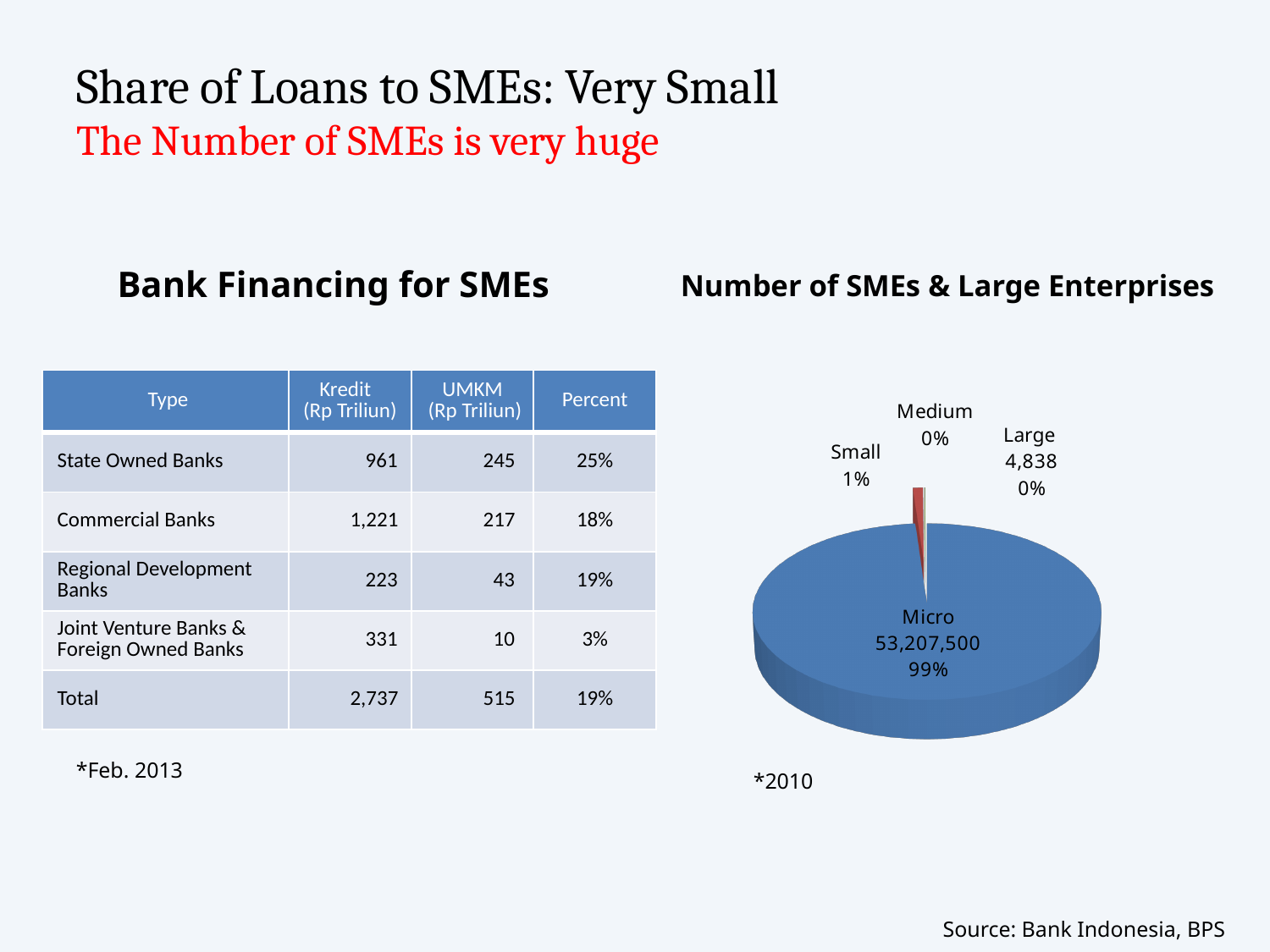
In the "Number of SMEs & Large Enterprises" pie chart, what is the number shown for Large? 4,838 In the "Number of SMEs & Large Enterprises" pie chart, what share of the pie is Micro? 99% What year is noted below the "Number of SMEs & Large Enterprises" pie chart? 2010 In the "Number of SMEs & Large Enterprises" pie chart, what is the number shown for Micro? 53,207,500 In the "Number of SMEs & Large Enterprises" pie chart, what is the difference between the number for Micro and the number for Large? 53,202,662 What kind of chart is shown under the title "Number of SMEs & Large Enterprises"? pie chart In the "Number of SMEs & Large Enterprises" pie chart, which category has the largest slice? Micro How many slices does the "Number of SMEs & Large Enterprises" pie chart have? 4 In the "Number of SMEs & Large Enterprises" pie chart, what share of the pie is Small? 1% In the "Number of SMEs & Large Enterprises" pie chart, what share of the pie is Large? 0% In the "Number of SMEs & Large Enterprises" pie chart, which is larger, the Micro slice or the Small slice? Micro